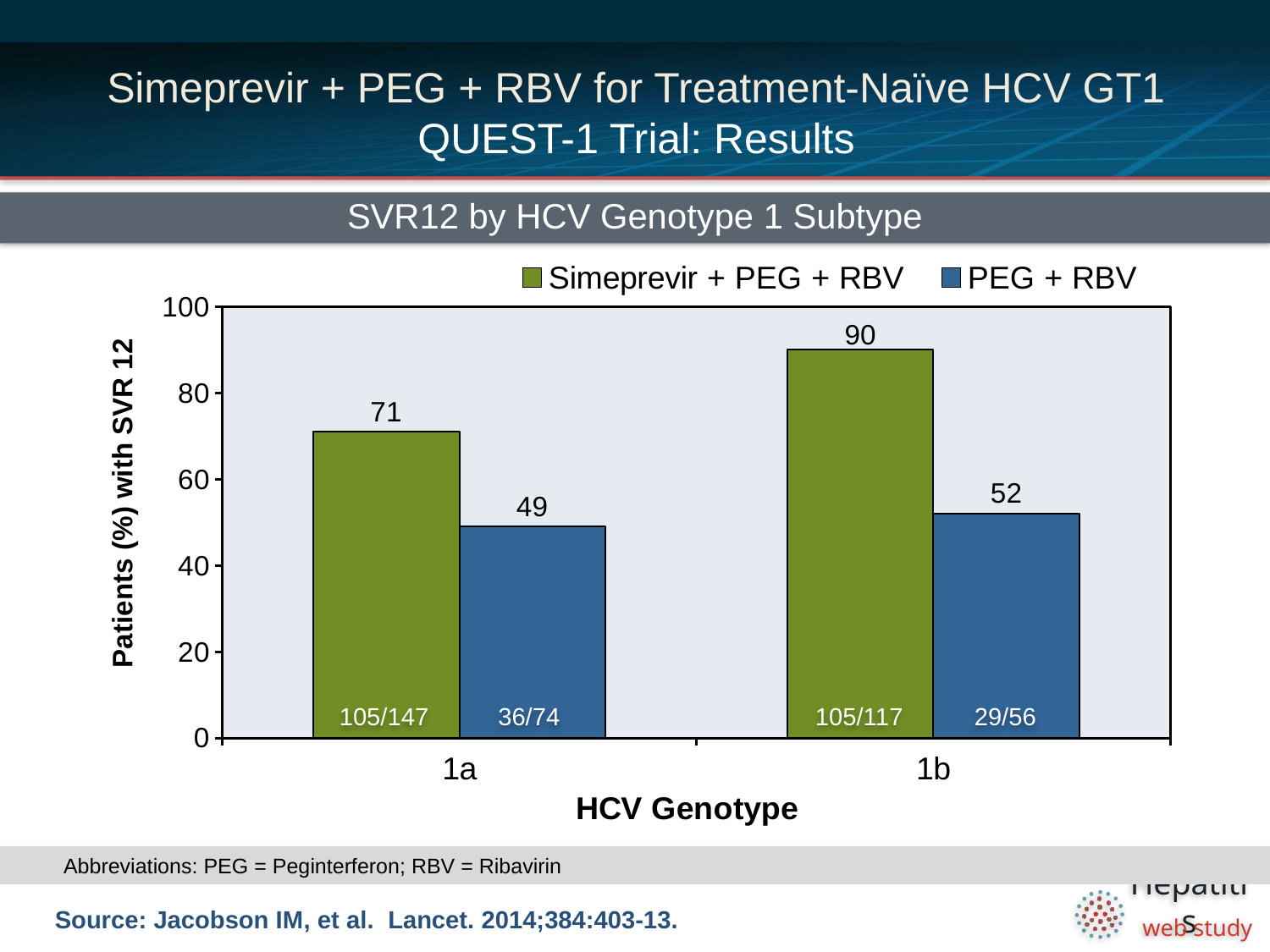
What is the difference in SVR12 rate between Simeprevir + PEG + RBV and PEG + RBV in genotype 1b? 38 What is the SVR12 rate for Simeprevir + PEG + RBV in genotype 1b? 90 Which bar shows the highest SVR12 rate? Simeprevir + PEG + RBV, genotype 1b What is the patient fraction shown for Simeprevir + PEG + RBV in genotype 1b? 105/117 What is the SVR12 rate for PEG + RBV in genotype 1b? 52 What is the difference in SVR12 rate between Simeprevir + PEG + RBV and PEG + RBV in genotype 1a? 22 Which has a higher SVR12 rate: PEG + RBV in genotype 1a or PEG + RBV in genotype 1b? PEG + RBV in genotype 1b What is the SVR12 rate for PEG + RBV in genotype 1a? 49 Which bar shows the lowest SVR12 rate? PEG + RBV, genotype 1a What is the SVR12 rate for Simeprevir + PEG + RBV in genotype 1a? 71 What kind of chart is shown? Bar chart How many series does the legend list? 2